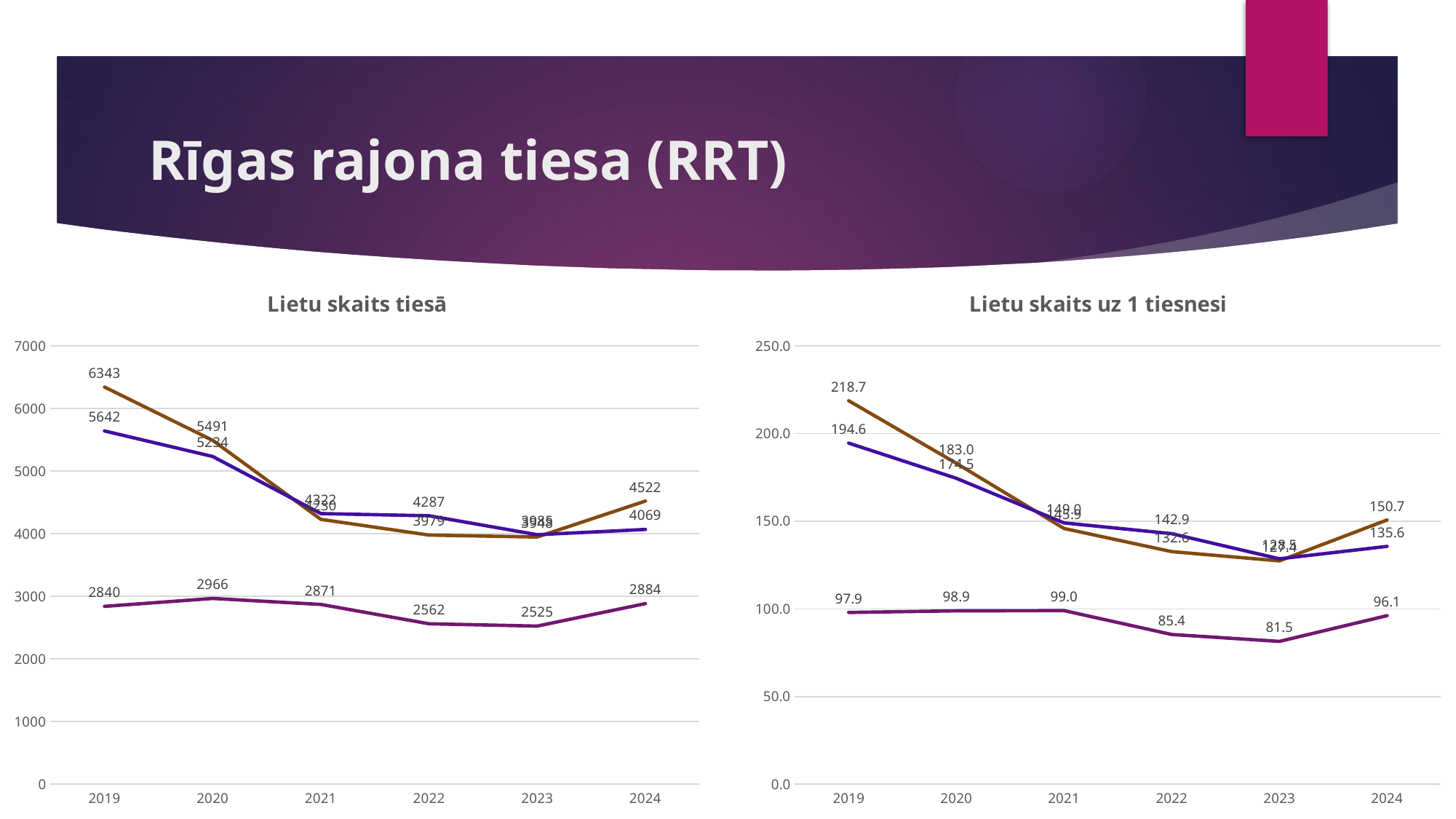
In the chart titled "Lietu skaits uz 1 tiesnesi", which is larger for 2019: the brown line or the blue line? The brown line In the chart titled "Lietu skaits tiesā", how many years are shown on the x axis? 6 In the chart titled "Lietu skaits uz 1 tiesnesi", what is the value of the purple line for 2023? 81.5 In the chart titled "Lietu skaits uz 1 tiesnesi", what is the value of the brown line for 2024? 150.7 In the chart titled "Lietu skaits uz 1 tiesnesi", is the value of the purple line for 2022 greater or less than 100.0? less In the chart titled "Lietu skaits tiesā", what is the difference between the purple line's values for 2020 and 2023? 441 In the chart titled "Lietu skaits tiesā", what is the value of the purple line for 2023? 2525 In the chart titled "Lietu skaits tiesā", what is the value of the brown line for 2019? 6343 In the chart titled "Lietu skaits tiesā", what is the value of the purple line for 2019? 2840 In the chart titled "Lietu skaits uz 1 tiesnesi", does the brown line rise or fall from 2019 to 2023? Fall What type of charts are shown on the slide? Line charts In the chart titled "Lietu skaits tiesā", in which year does the purple line reach its highest value? 2020